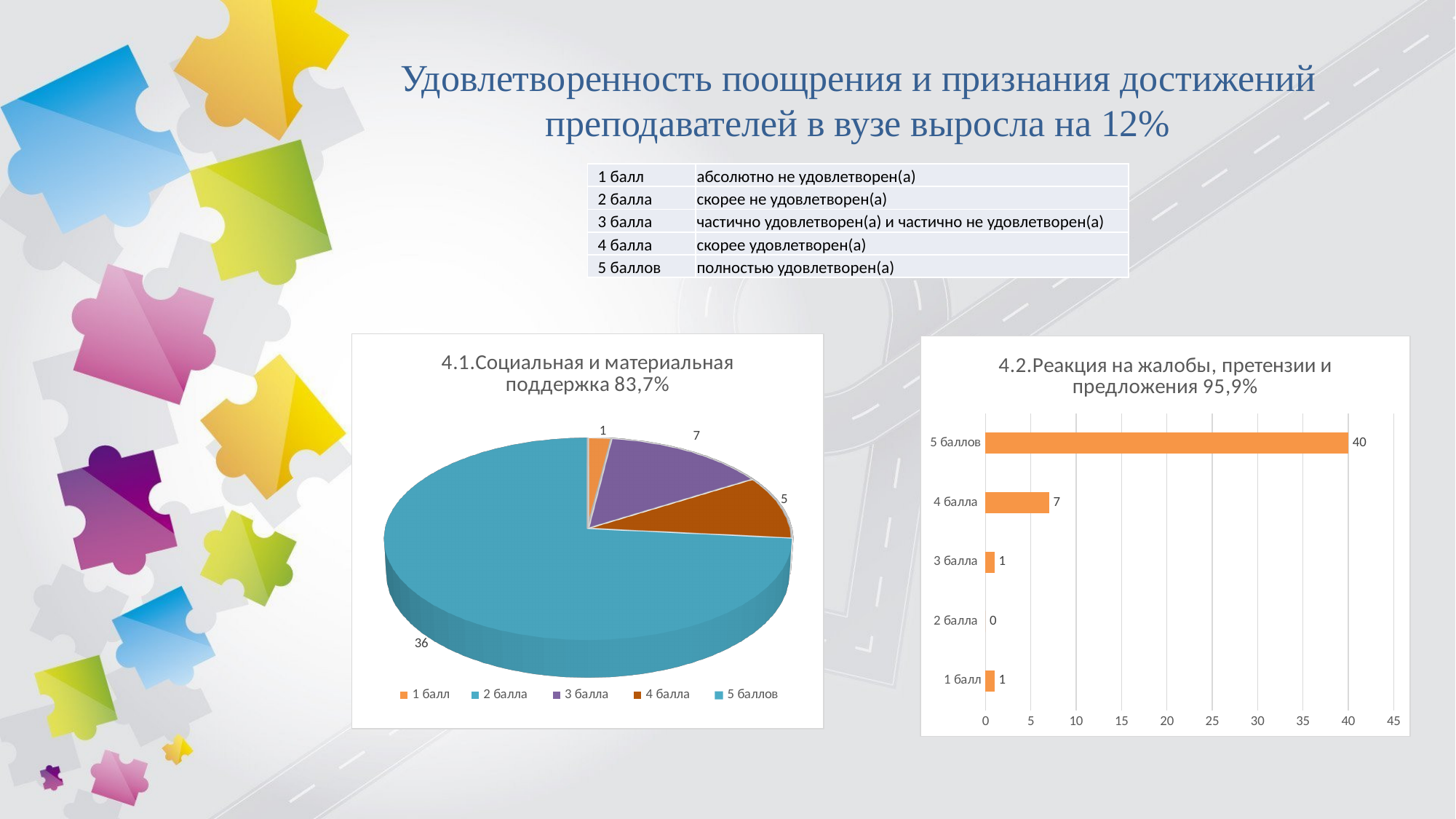
In the chart '4.2.Реакция на жалобы, претензии и предложения 95,9%', what is the value for 5 баллов? 40 In the chart '4.2.Реакция на жалобы, претензии и предложения 95,9%', what is the value for 4 балла? 7 How many entries does the legend of the pie chart '4.1.Социальная и материальная поддержка 83,7%' list? 5 In the chart '4.2.Реакция на жалобы, претензии и предложения 95,9%', how many categories are shown? 5 In the pie chart '4.1.Социальная и материальная поддержка 83,7%', which is larger, the value for 3 балла or the value for 4 балла? 3 балла What kind of chart is '4.2.Реакция на жалобы, претензии и предложения 95,9%'? bar chart In the pie chart '4.1.Социальная и материальная поддержка 83,7%', what is the value for 5 баллов? 36 In the chart '4.2.Реакция на жалобы, претензии и предложения 95,9%', what is the value for 2 балла? 0 In the chart '4.2.Реакция на жалобы, претензии и предложения 95,9%', what is the difference between the values for 5 баллов and 4 балла? 33 In the chart '4.2.Реакция на жалобы, претензии и предложения 95,9%', which category has the highest value? 5 баллов In the chart '4.2.Реакция на жалобы, претензии и предложения 95,9%', which category has the lowest value? 2 балла In the pie chart '4.1.Социальная и материальная поддержка 83,7%', what is the value for 3 балла? 7